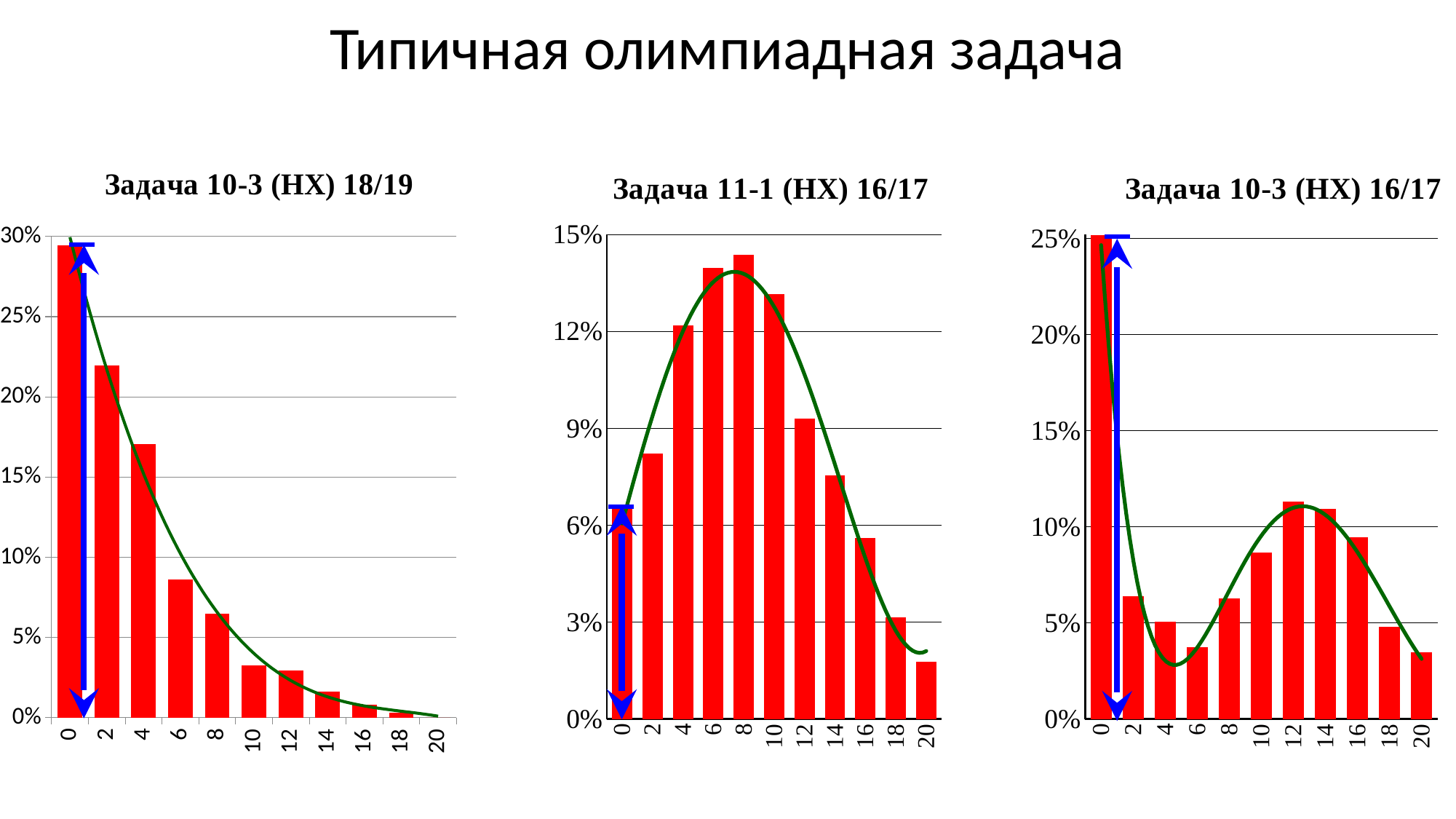
In the chart titled "Задача 11-1 (НХ) 16/17", which x-axis category has the highest bar? 8 In the chart titled "Задача 10-3 (НХ) 18/19", is the value for 4 greater or less than 15%? greater In the chart titled "Задача 10-3 (НХ) 16/17", is the value for 12 greater or less than 10%? greater How many charts are shown on the slide? 3 In the chart titled "Задача 11-1 (НХ) 16/17", is the value for 14 greater or less than 6%? greater In the chart titled "Задача 11-1 (НХ) 16/17", which x-axis category has the lowest bar? 20 In the chart titled "Задача 10-3 (НХ) 18/19", do the bar values rise or fall as the x-axis goes from 0 to 20? fall What kind of chart is used in the chart titled "Задача 10-3 (НХ) 18/19"? bar chart In the chart titled "Задача 11-1 (НХ) 16/17", how many x-axis categories are labelled? 11 In the chart titled "Задача 10-3 (НХ) 16/17", which x-axis category has the highest bar? 0 In the chart titled "Задача 10-3 (НХ) 18/19", which x-axis category has the highest bar? 0